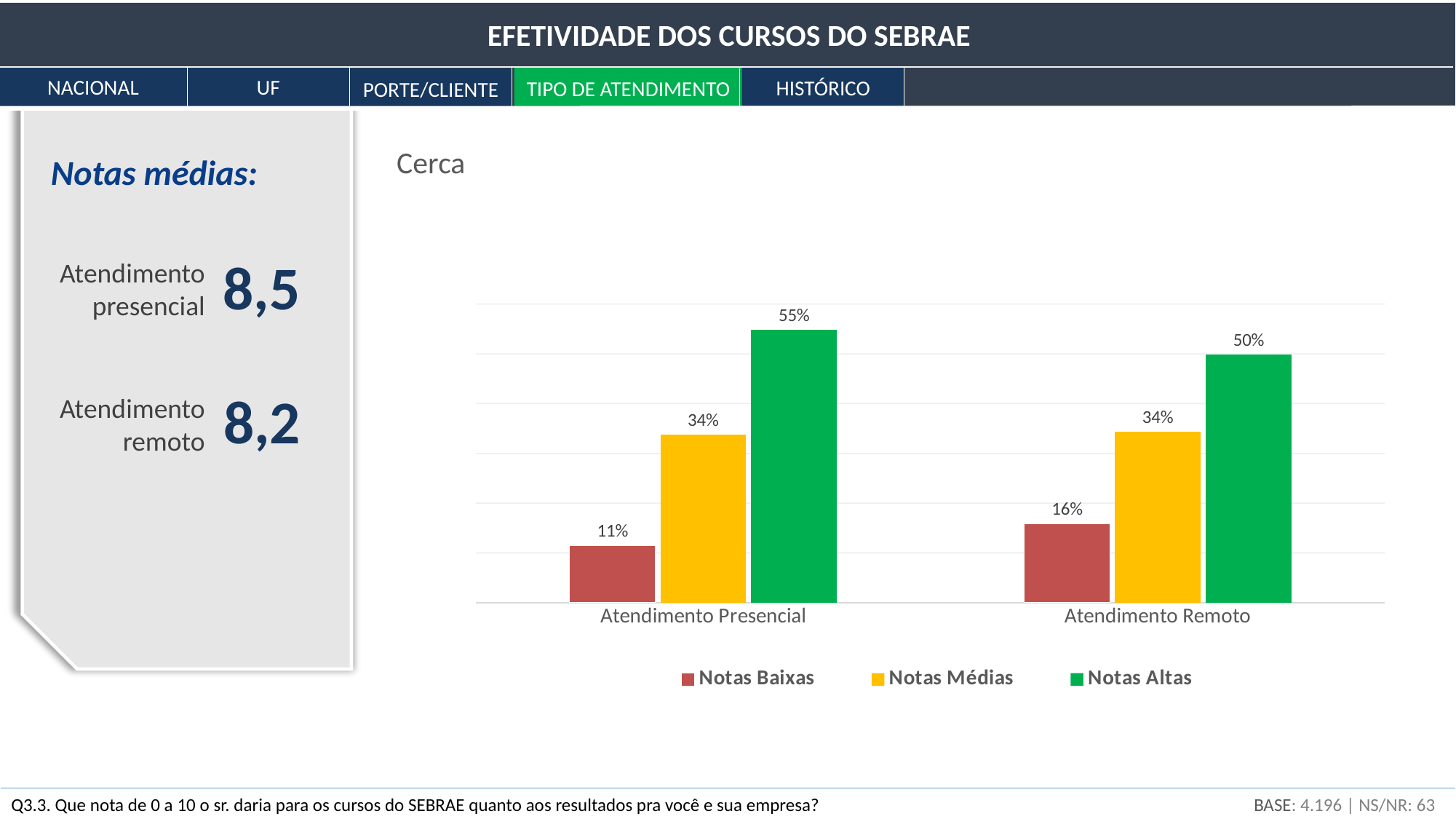
Which series has the highest value for Atendimento Presencial? Notas Altas What kind of chart is shown on the slide? Bar chart What is the value for Notas Médias in Atendimento Remoto? 34% What is the difference between Notas Baixas for Atendimento Remoto and Atendimento Presencial? 5% Which is larger: Notas Baixas for Atendimento Presencial or Notas Baixas for Atendimento Remoto? Atendimento Remoto What is the difference between Notas Altas for Atendimento Presencial and Atendimento Remoto? 5% Which colour represents Notas Médias in the chart? Yellow Which series has the lowest value for Atendimento Remoto? Notas Baixas What is the value for Notas Altas in Atendimento Presencial? 55% How many categories are shown on the x axis of the chart? 2 How many series does the chart legend list? 3 What is the value for Notas Baixas in Atendimento Remoto? 16%